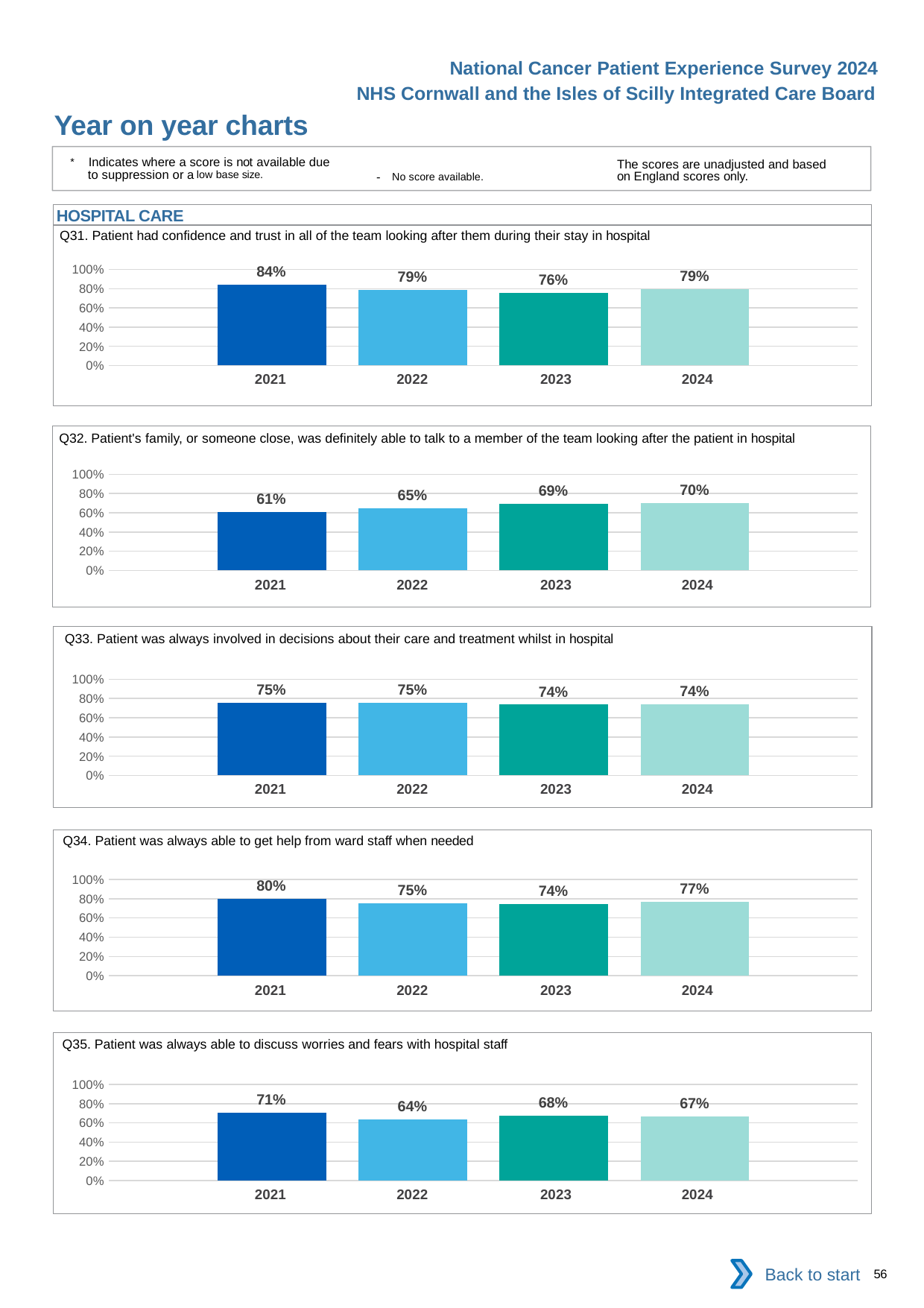
How many years are shown on the x axis of the Q31 chart? 4 In the Q33 chart, is the value for 2024 greater or less than 60%? greater In the Q32 chart, which year has the highest value? 2024 In the Q31 chart, what is the value for 2021? 84% What kind of chart is the Q34 chart? bar chart In the Q34 chart, what is the difference between the 2021 and 2023 values? 6% In the Q32 chart, do the values rise or fall from 2021 to 2024? rise In the Q32 chart, which year has the lowest value? 2021 In the Q31 chart, what is the difference between the 2021 and 2023 values? 8% Which section heading appears above the Q31 chart? HOSPITAL CARE In the Q35 chart, which is larger, the value for 2021 or the value for 2022? 2021 In the Q35 chart, what is the value for 2023? 68%